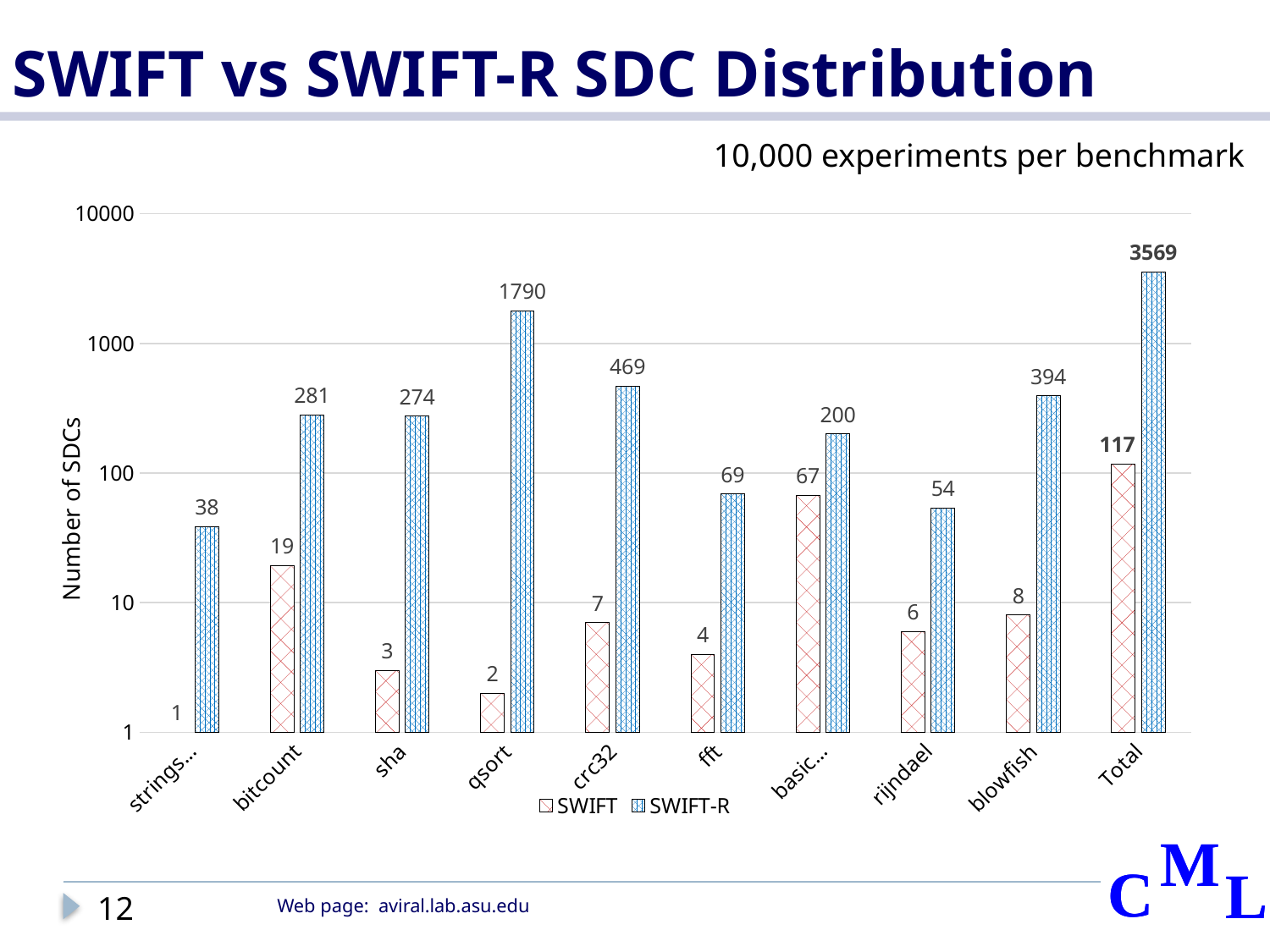
What is the SWIFT-R value for qsort? 1790 What kind of chart is shown on the slide? bar chart Which has the larger SWIFT-R value, bitcount or sha? bitcount Which of rijndael, fft and blowfish has the lowest SWIFT-R value? rijndael How many series does the legend list? 2 How many categories are shown on the x axis? 10 What is the SWIFT-R value for blowfish? 394 Excluding Total, which benchmark has the highest SWIFT-R value? qsort What is the difference between the SWIFT-R and SWIFT values for Total? 3452 What is the SWIFT value for bitcount? 19 Is the SWIFT-R value for crc32 greater or less than 100? greater What is the SWIFT value for the Total category? 117